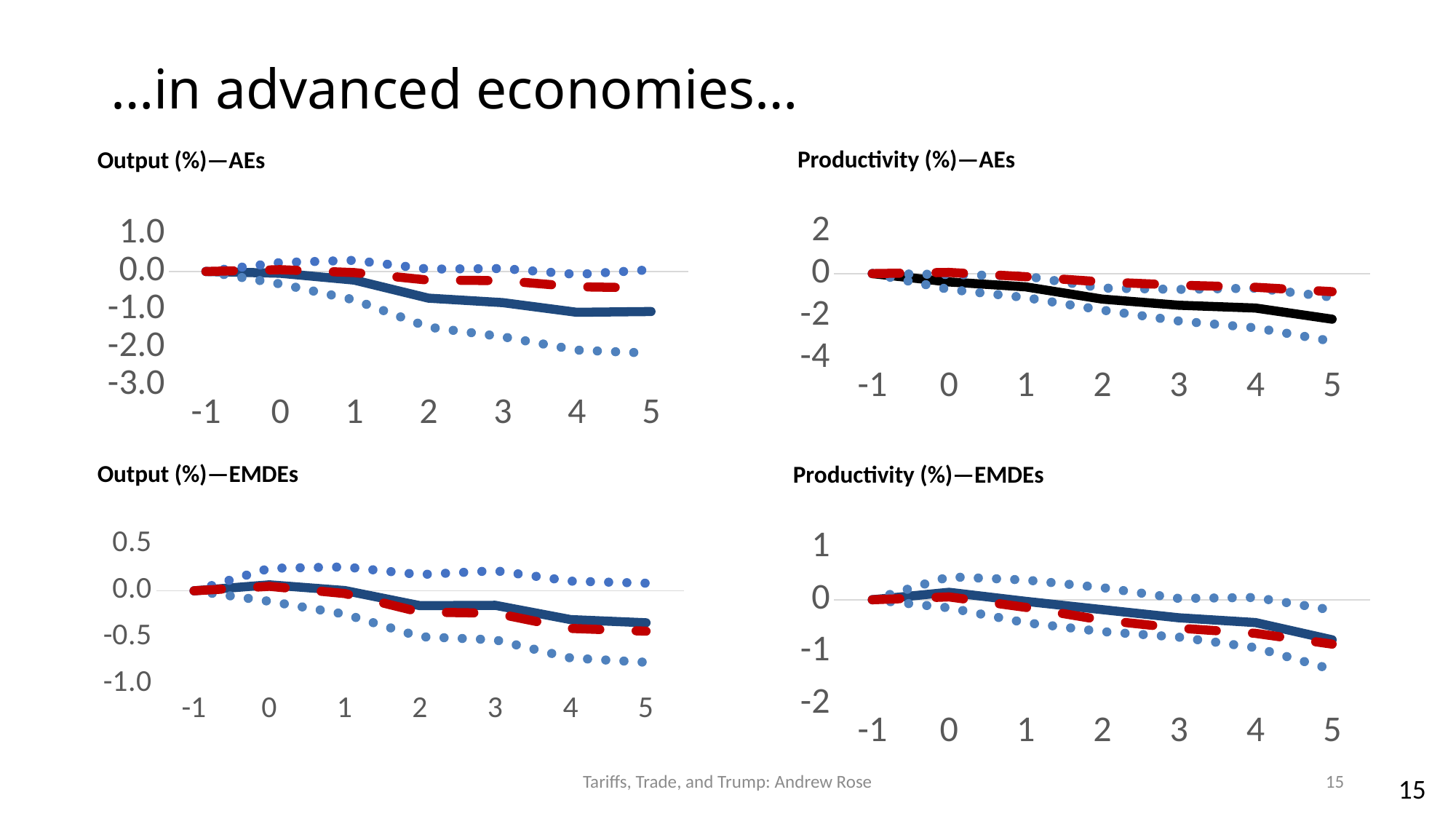
In the "Output (%)—EMDEs" chart, is the value of the solid line at x = 5 greater or less than -0.5? greater In the "Productivity (%)—EMDEs" chart, does the solid line rise or fall from x = 0 to x = 5? fall What kind of chart is the "Output (%)—AEs" chart? line chart In the "Output (%)—EMDEs" chart, is the value of the lower dotted line at x = 5 greater or less than -0.5? less In the "Output (%)—AEs" chart, is the value of the lower dotted line at x = 2 greater or less than -1.0? less In the "Output (%)—AEs" chart, does the solid line rise or fall from x = -1 to x = 5? fall How many charts are shown on the slide? 4 How many x-axis points are shown on the "Productivity (%)—AEs" chart? 7